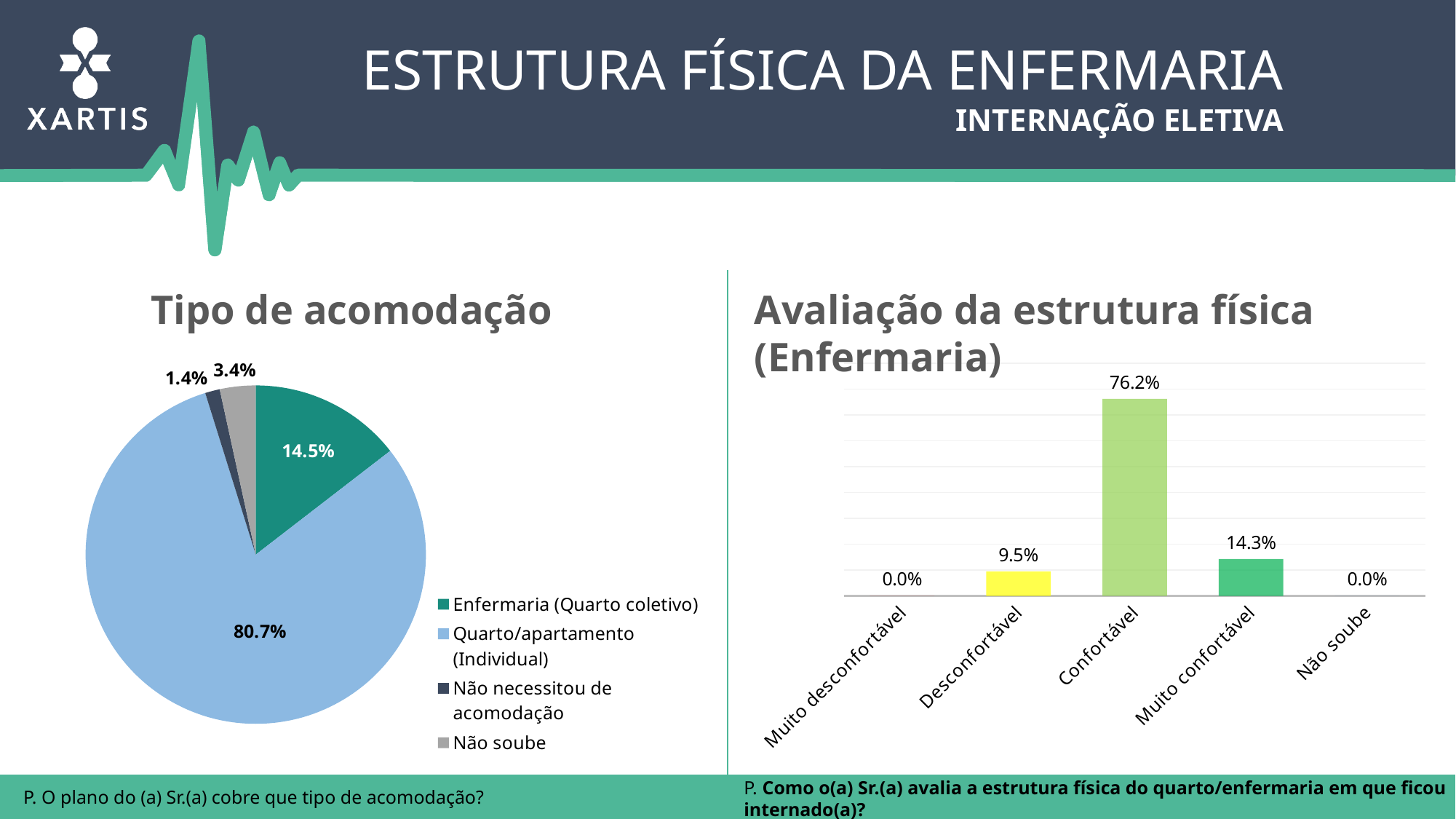
What kind of chart is 'Avaliação da estrutura física (Enfermaria)'? Bar chart In the 'Avaliação da estrutura física (Enfermaria)' chart, what value is shown for Confortável? 76.2% In the 'Tipo de acomodação' pie chart, what share is shown for Quarto/apartamento (Individual)? 80.7% In the 'Tipo de acomodação' pie chart, what share is shown for Não necessitou de acomodação? 1.4% In the 'Avaliação da estrutura física (Enfermaria)' chart, which category has the highest value? Confortável In the 'Tipo de acomodação' pie chart, what is the difference between the Enfermaria (Quarto coletivo) share and the Não soube share? 11.1% In the 'Tipo de acomodação' pie chart, which category has the largest slice? Quarto/apartamento (Individual) In the 'Tipo de acomodação' pie chart, which category has the smallest slice? Não necessitou de acomodação In the 'Tipo de acomodação' pie chart, how many categories does the legend list? 4 In the 'Avaliação da estrutura física (Enfermaria)' chart, what value is shown for Desconfortável? 9.5% In the 'Avaliação da estrutura física (Enfermaria)' chart, what is the difference between Confortável and Muito confortável? 61.9% In the 'Tipo de acomodação' pie chart, what share is shown for Enfermaria (Quarto coletivo)? 14.5%